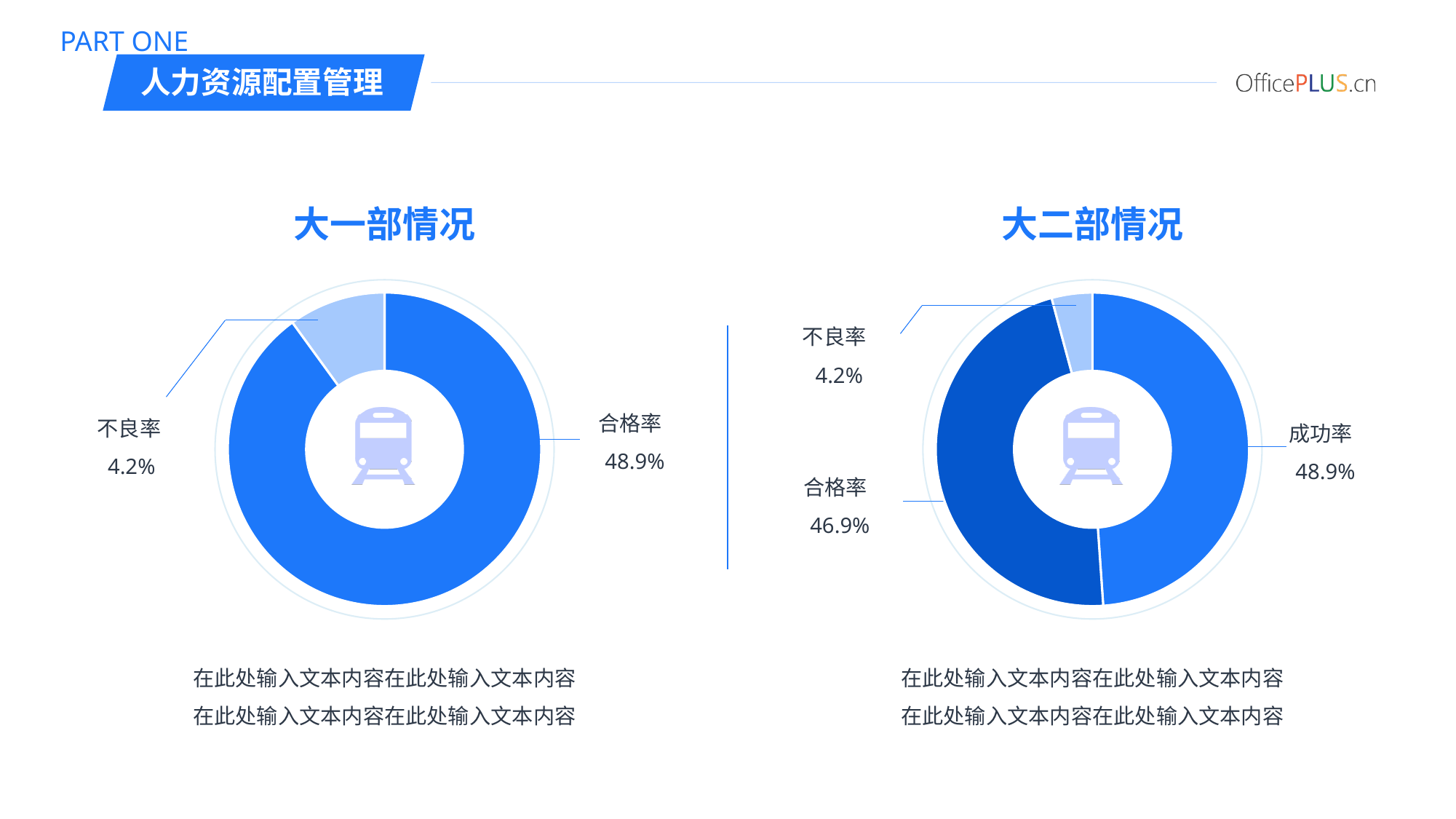
In the 大二部情况 chart, what is the value for 不良率? 4.2% In the 大一部情况 chart, what is the value for 合格率? 48.9% What type of chart is used for 大一部情况? Donut (pie) chart In the 大二部情况 chart, what is the value for 合格率? 46.9% In the 大一部情况 chart, what is the value for 不良率? 4.2% How many labeled categories does the 大二部情况 chart show? 3 In the 大一部情况 chart, which is larger, 合格率 or 不良率? 合格率 In the 大二部情况 chart, what is the value for 成功率? 48.9% In the 大二部情况 chart, what is the difference between 成功率 and 合格率? 2.0% In the 大二部情况 chart, which category has the highest value? 成功率 In the 大二部情况 chart, which category has the lowest value? 不良率 What is the title of the chart on the left side of the slide? 大一部情况